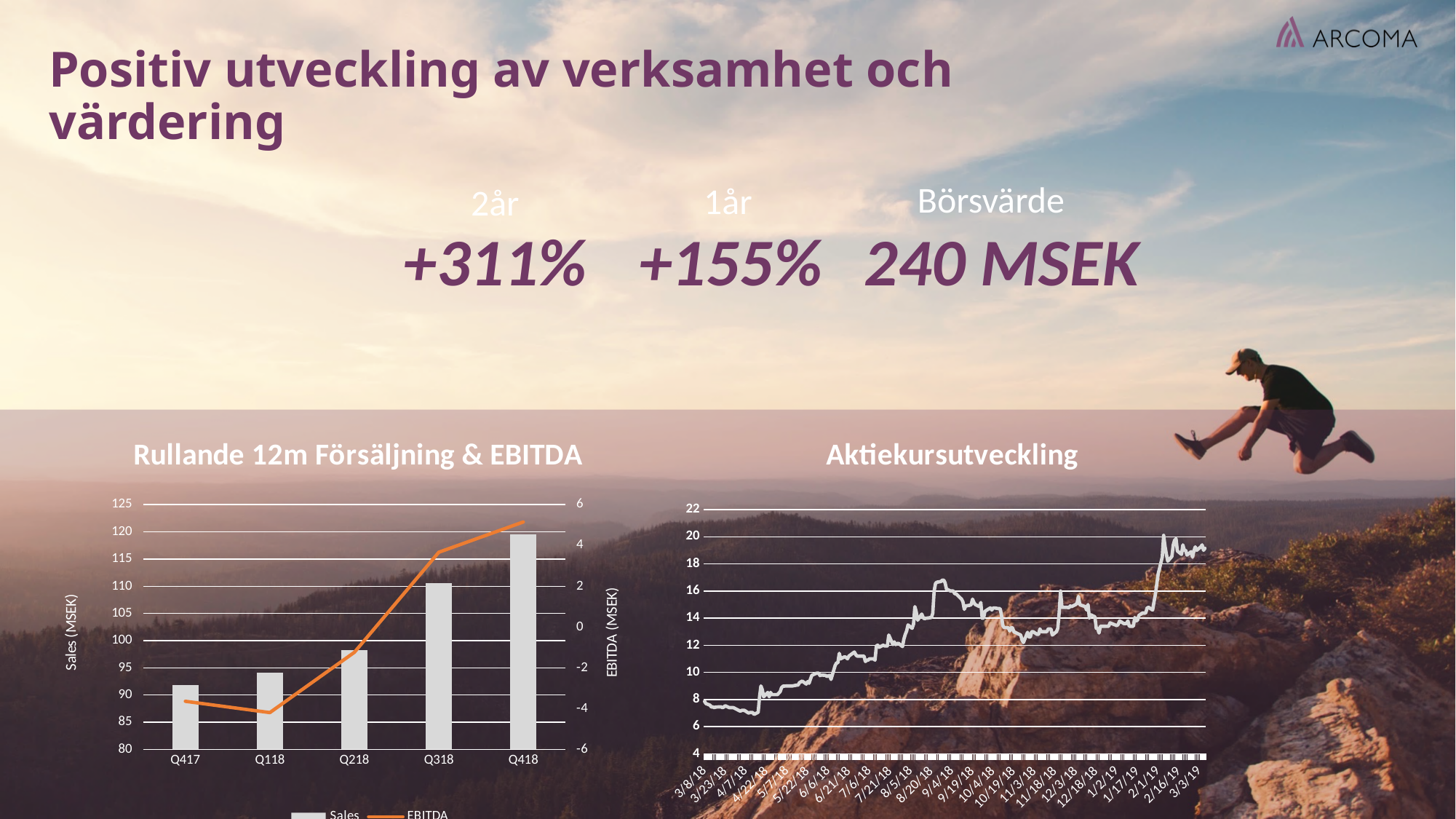
In the 'Rullande 12m Försäljning & EBITDA' chart, is the Sales value for Q418 greater or less than 115? greater How many series does the legend of the 'Rullande 12m Försäljning & EBITDA' chart list? 2 In the 'Aktiekursutveckling' chart, is the share price at the start (3/8/18) greater or less than 10? less What type of chart is the 'Aktiekursutveckling' chart? Line chart In the 'Rullande 12m Försäljning & EBITDA' chart, is the EBITDA value for Q118 greater or less than -2? less In the 'Rullande 12m Försäljning & EBITDA' chart, which quarter has the highest Sales bar? Q418 In the 'Aktiekursutveckling' chart, does the share price generally rise or fall from 3/8/18 to 3/3/19? Rise How many quarters are shown on the x axis of the 'Rullande 12m Försäljning & EBITDA' chart? 5 In the 'Rullande 12m Försäljning & EBITDA' chart, which quarter has the lowest Sales bar? Q417 In the 'Rullande 12m Försäljning & EBITDA' chart, which has the larger Sales bar, Q218 or Q318? Q318 What type of chart is the 'Rullande 12m Försäljning & EBITDA' chart? Combined bar and line chart